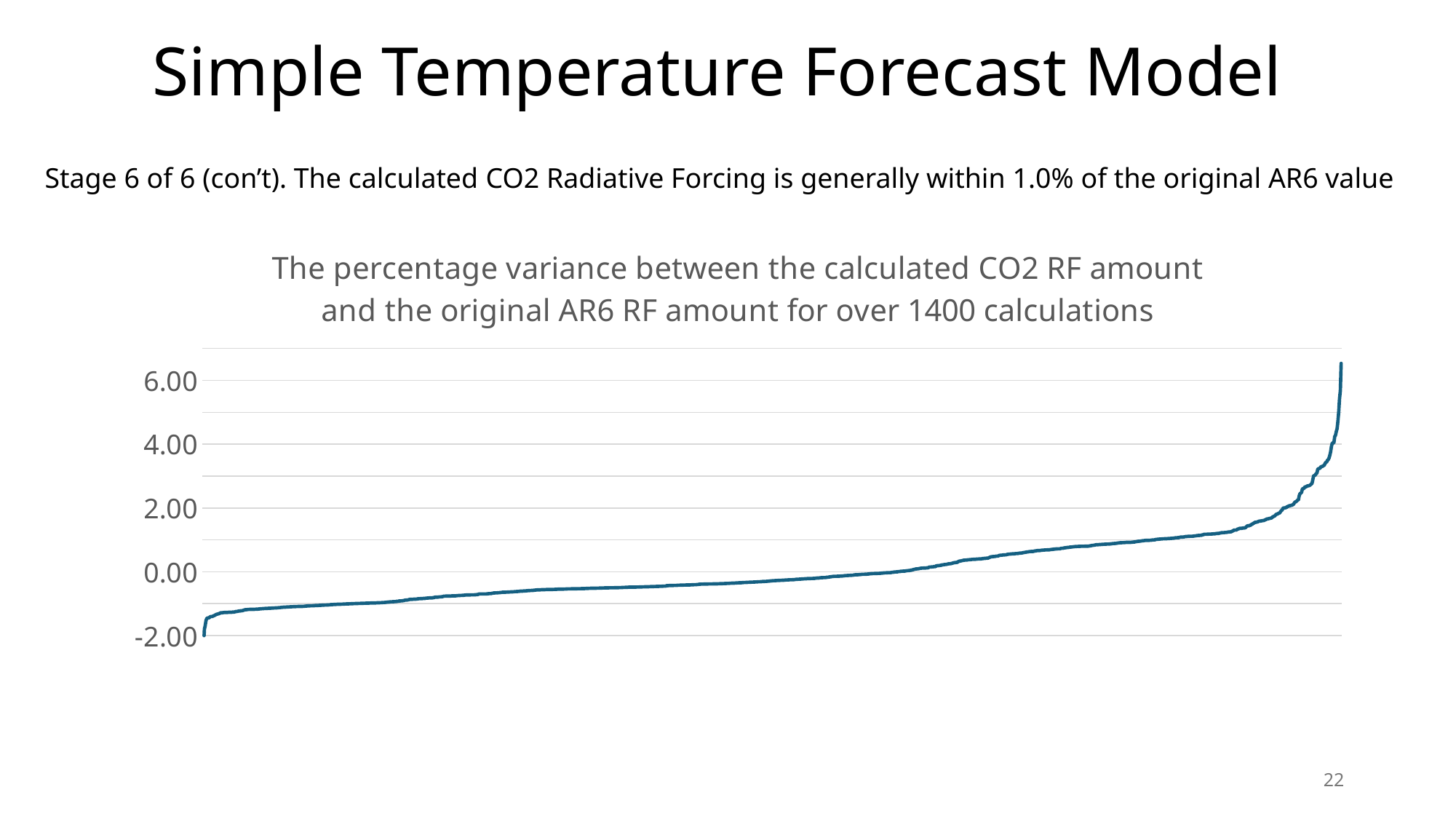
Is the value of the line at the midpoint of the x axis greater or less than -2.00? greater What kind of chart is shown on the slide? line chart Is the highest value reached by the line at the right end greater or less than 6.00? greater Is the lowest value of the line at the left end greater or less than -1.00? less What is the lowest tick label shown on the vertical axis? -2.00 What is the highest tick label shown on the vertical axis? 6.00 Do the plotted values rise or fall from left to right along the x axis? rise